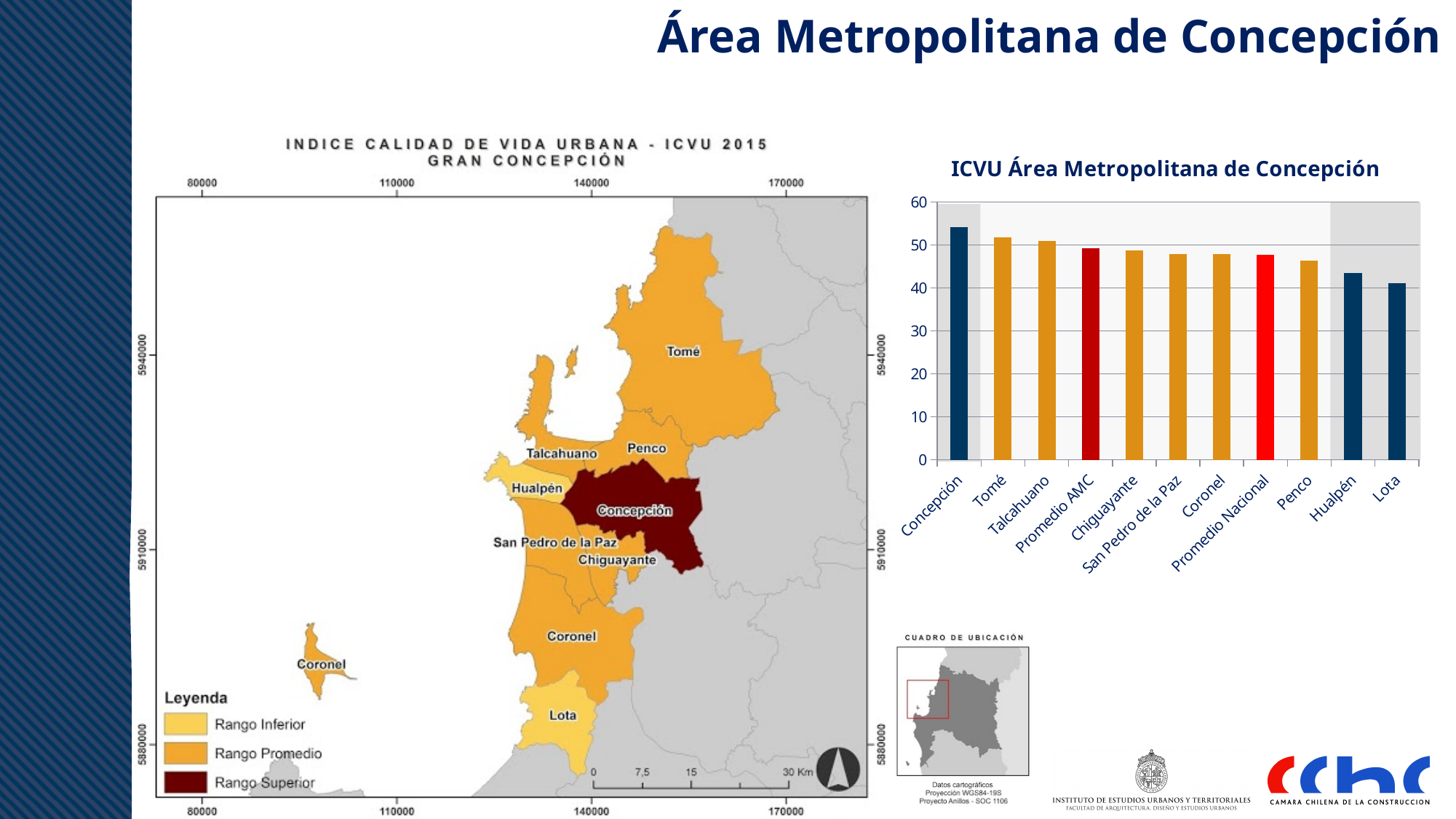
In the 'ICVU Área Metropolitana de Concepción' chart, is the value for Penco greater or less than 50? less What kind of chart is the 'ICVU Área Metropolitana de Concepción' chart? bar chart In the 'ICVU Área Metropolitana de Concepción' chart, is the value for Concepción greater or less than 50? greater In the 'ICVU Área Metropolitana de Concepción' chart, is the value for Lota greater or less than 50? less In the 'ICVU Área Metropolitana de Concepción' chart, which is larger, the value for Lota or the value for Concepción? Concepción In the 'ICVU Área Metropolitana de Concepción' chart, how many bars are plotted? 11 In the 'ICVU Área Metropolitana de Concepción' chart, which category has the lowest value? Lota What is the title of the bar chart on the right side of the slide? ICVU Área Metropolitana de Concepción In the 'ICVU Área Metropolitana de Concepción' chart, do the values generally rise or fall from left to right along the x axis? fall In the 'ICVU Área Metropolitana de Concepción' chart, which category has the highest value? Concepción In the 'ICVU Área Metropolitana de Concepción' chart, which is larger, the value for Tomé or the value for Hualpén? Tomé